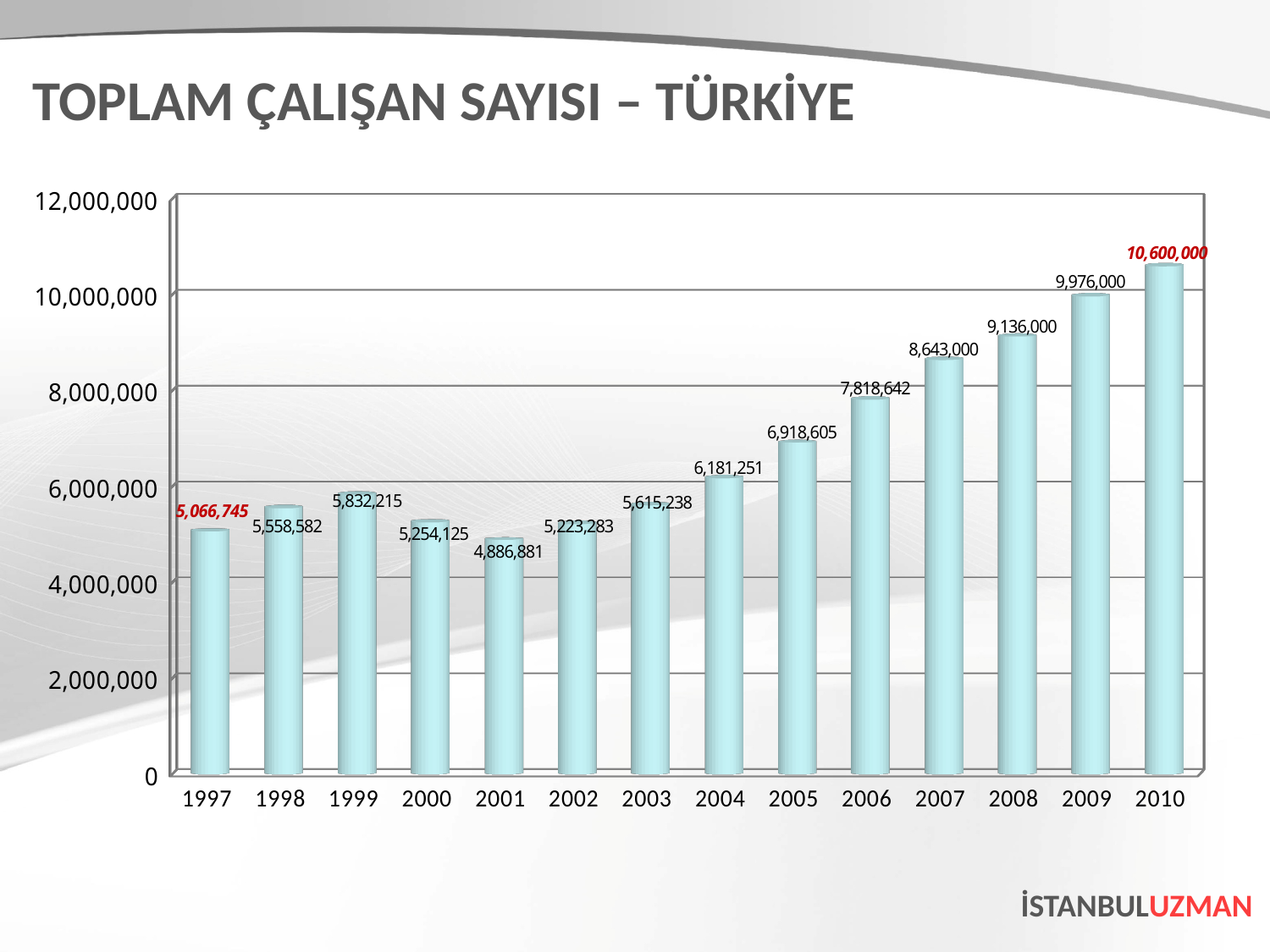
How many years are shown on the x axis? 14 Which year has the highest value? 2010 What is the value for 2010? 10,600,000 What is the value for 1997? 5,066,745 Which is larger, the value for 1999 or the value for 2003? 1999 What is the difference between the values for 2008 and 2007? 493,000 What is the value for 2001? 4,886,881 What is the difference between the values for 2010 and 2009? 624,000 What is the value for 2005? 6,918,605 Which year has the lowest value? 2001 What kind of chart is shown on the slide? bar chart Is the value for 2006 greater or less than 8,000,000? less